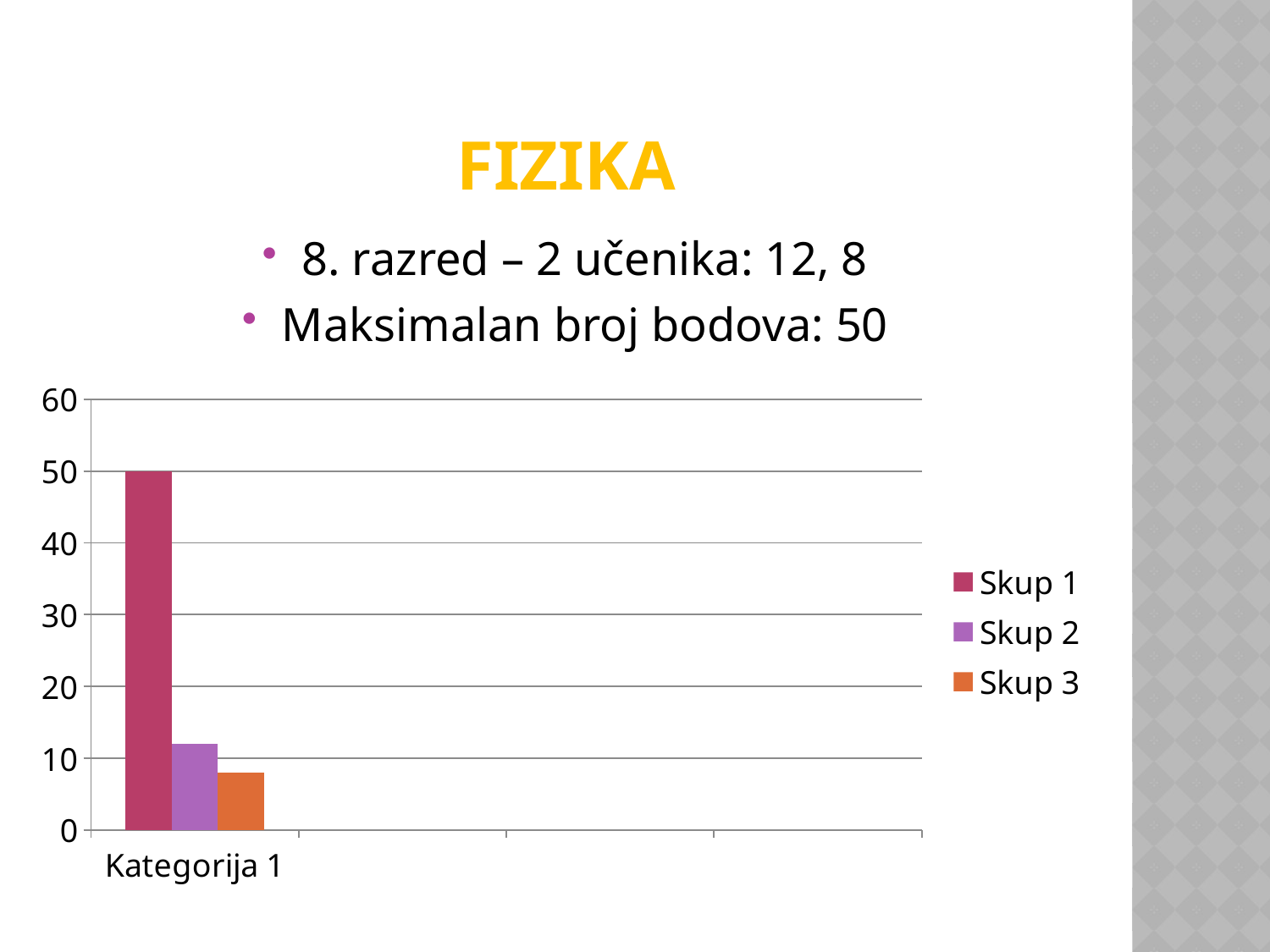
Which series has the highest value for Kategorija 1? Skup 1 What is the highest value shown on the y axis of the chart? 60 Which is larger, the value for Skup 2 or the value for Skup 3? Skup 2 Is the value for Skup 3 greater or less than 10? less How many series does the chart legend list? 3 How many categories are shown on the x axis of the chart? 1 Which series has the lowest value for Kategorija 1? Skup 3 Is the value for Skup 2 greater or less than 20? less What kind of chart is shown on the slide? bar chart What is the label of the category on the x axis? Kategorija 1 What is the value of Skup 1 for Kategorija 1? 50 Is the value for Skup 2 greater or less than 10? greater